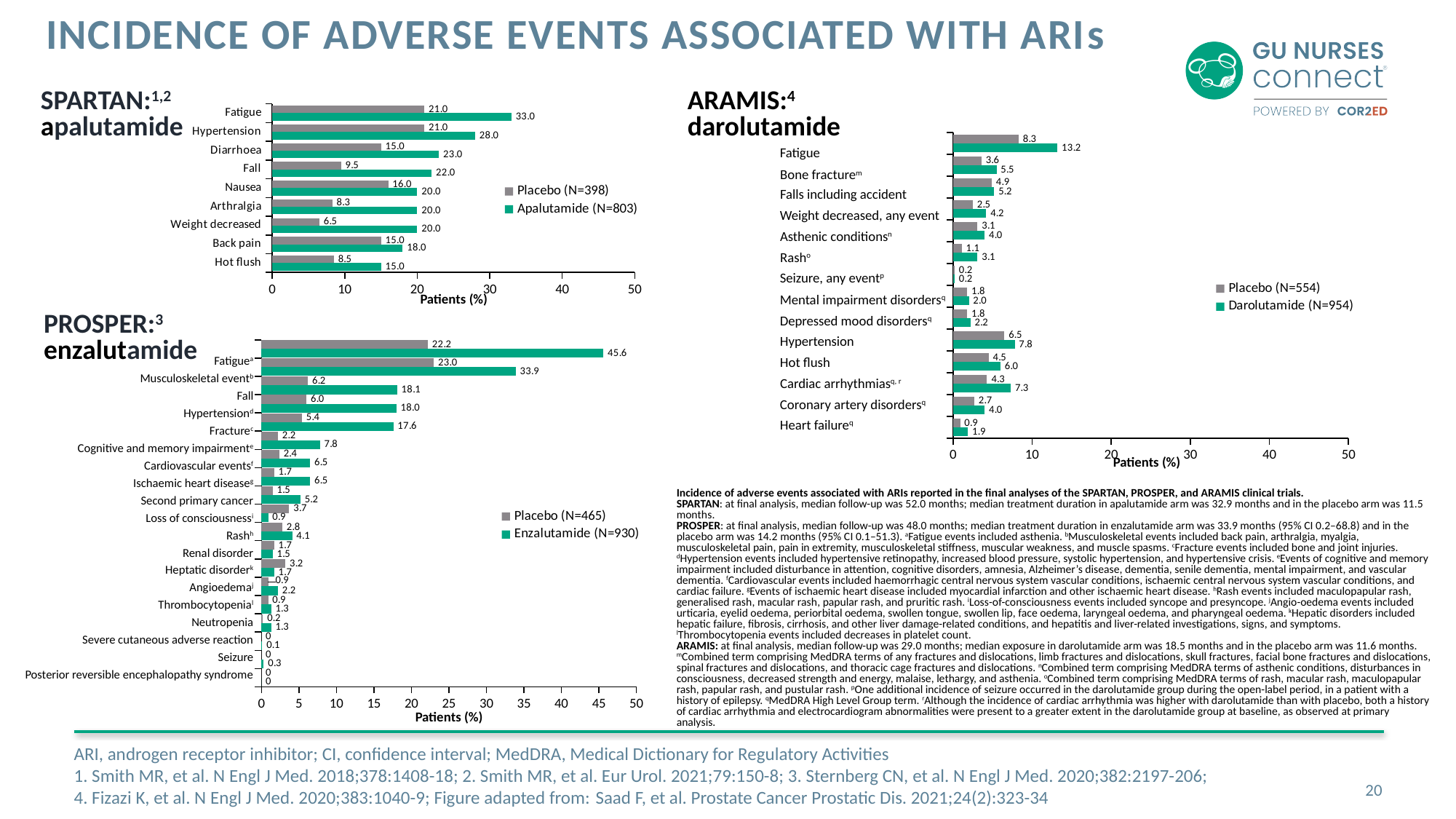
In the SPARTAN apalutamide chart, what is the difference between the Apalutamide and Placebo values for Weight decreased? 13.5 In the SPARTAN apalutamide chart, which adverse event has the highest Apalutamide value? Fatigue In the PROSPER enzalutamide chart, what is the value for Fatigue in the Enzalutamide (N=930) series? 45.6 In the SPARTAN apalutamide chart, how many adverse event categories are shown? 9 In the PROSPER enzalutamide chart, which is larger: the Enzalutamide value for Fall or the Enzalutamide value for Fracture? Fall In the SPARTAN apalutamide chart, what is the value for Fall in the Placebo (N=398) series? 9.5 In the ARAMIS darolutamide chart, what is the difference between the Darolutamide and Placebo values for Cardiac arrhythmias? 3.0 In the ARAMIS darolutamide chart, how many series does the legend list? 2 In the ARAMIS darolutamide chart, what is the value for Fatigue in the Darolutamide (N=954) series? 13.2 What type of chart is the ARAMIS darolutamide chart? Bar chart In the SPARTAN apalutamide chart, what is the value for Fatigue in the Apalutamide (N=803) series? 33.0 In the PROSPER enzalutamide chart, what is the value for Musculoskeletal event in the Placebo (N=465) series? 23.0